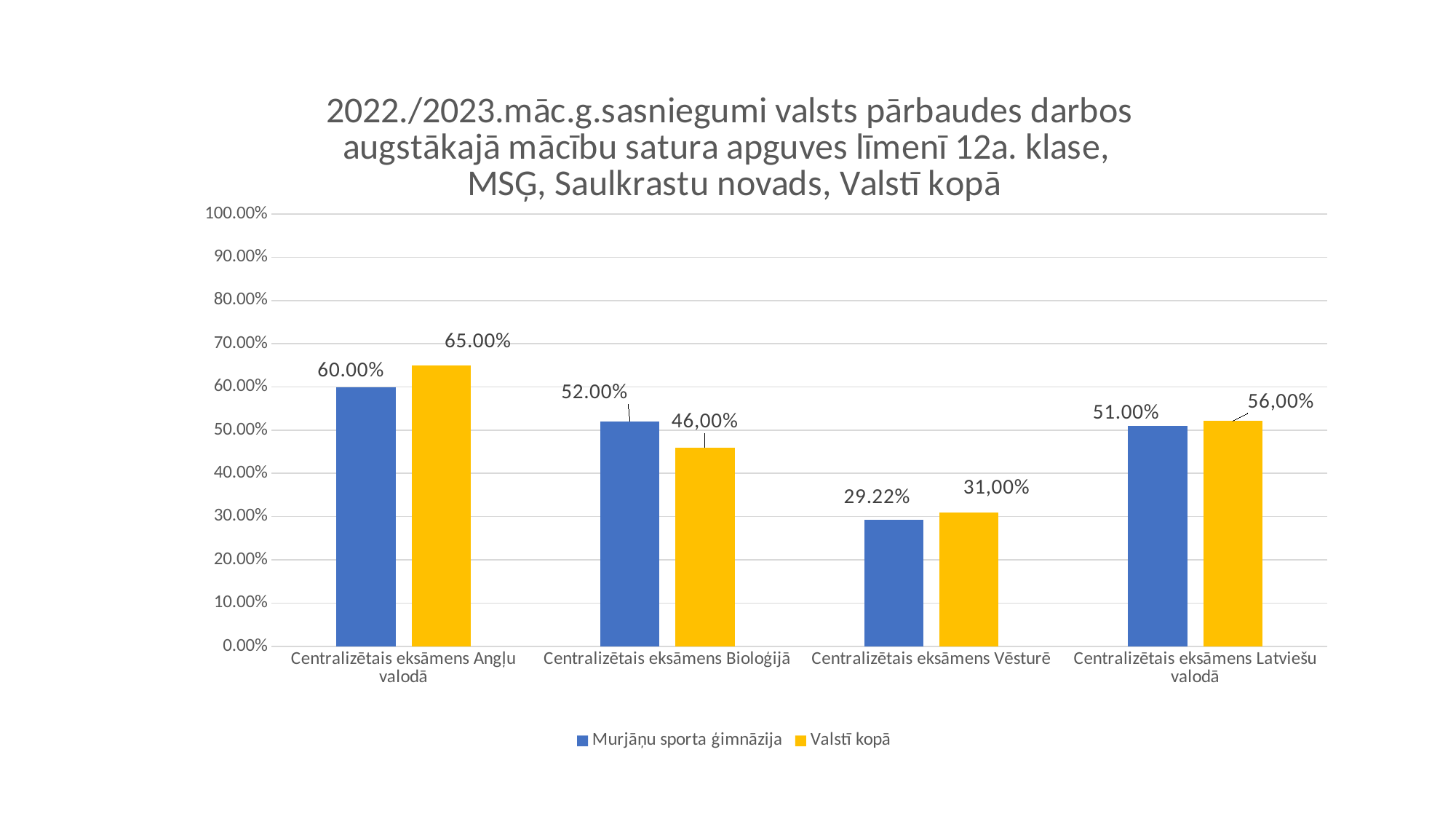
What is the difference between the Valstī kopā and Murjāņu sporta ģimnāzija values in Centralizētais eksāmens Angļu valodā? 5.00% What is the value for Valstī kopā in Centralizētais eksāmens Bioloģijā? 46,00% What is the difference between the Murjāņu sporta ģimnāzija and Valstī kopā values in Centralizētais eksāmens Bioloģijā? 6.00% How many exam categories are shown on the x axis? 4 In which exam does Valstī kopā have its lowest value? Centralizētais eksāmens Vēsturē What is the value for Murjāņu sporta ģimnāzija in Centralizētais eksāmens Vēsturē? 29.22% What is the value for Valstī kopā in Centralizētais eksāmens Latviešu valodā? 56,00% Which series has the larger value in Centralizētais eksāmens Bioloģijā? Murjāņu sporta ģimnāzija What kind of chart is shown on the slide? Bar chart In which exam does Murjāņu sporta ģimnāzija have its highest value? Centralizētais eksāmens Angļu valodā How many series does the legend list? 2 What is the value for Murjāņu sporta ģimnāzija in Centralizētais eksāmens Angļu valodā? 60.00%